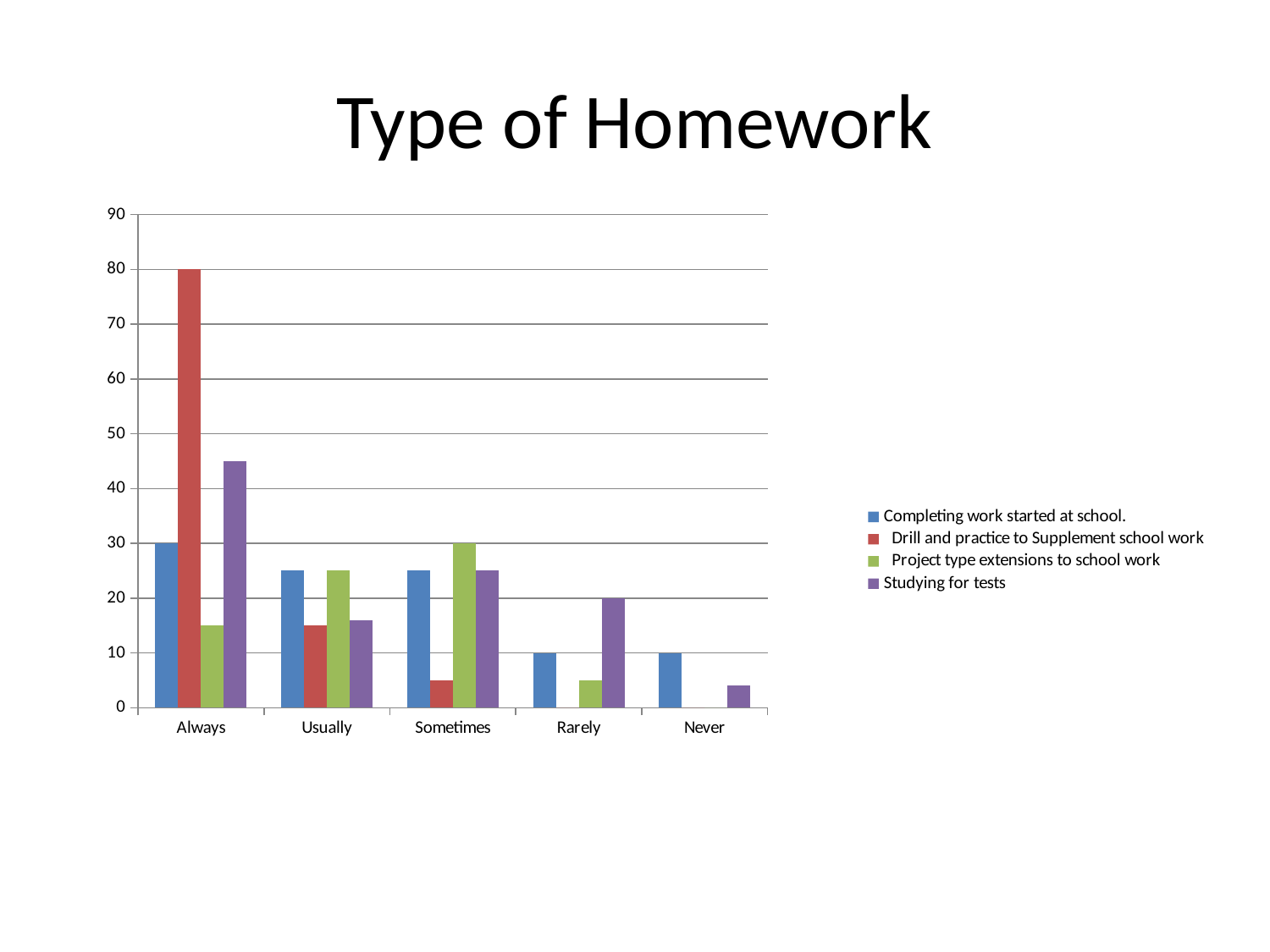
What is the value for 'Completing work started at school.' in the Never category? 10 How many categories are shown on the x axis? 5 What is the value for 'Studying for tests' in the Rarely category? 20 What is the value for 'Project type extensions to school work' in the Sometimes category? 30 How many series does the legend list? 4 What is the value for 'Drill and practice to Supplement school work' in the Always category? 80 What is the value for 'Completing work started at school.' in the Always category? 30 Which category has the highest value for 'Drill and practice to Supplement school work'? Always What is the title of the chart? Type of Homework What type of chart is shown on the slide? bar chart Which is larger in the Usually category: 'Completing work started at school.' or 'Drill and practice to Supplement school work'? Completing work started at school. Is the value for 'Studying for tests' in the Always category greater or less than 40? greater